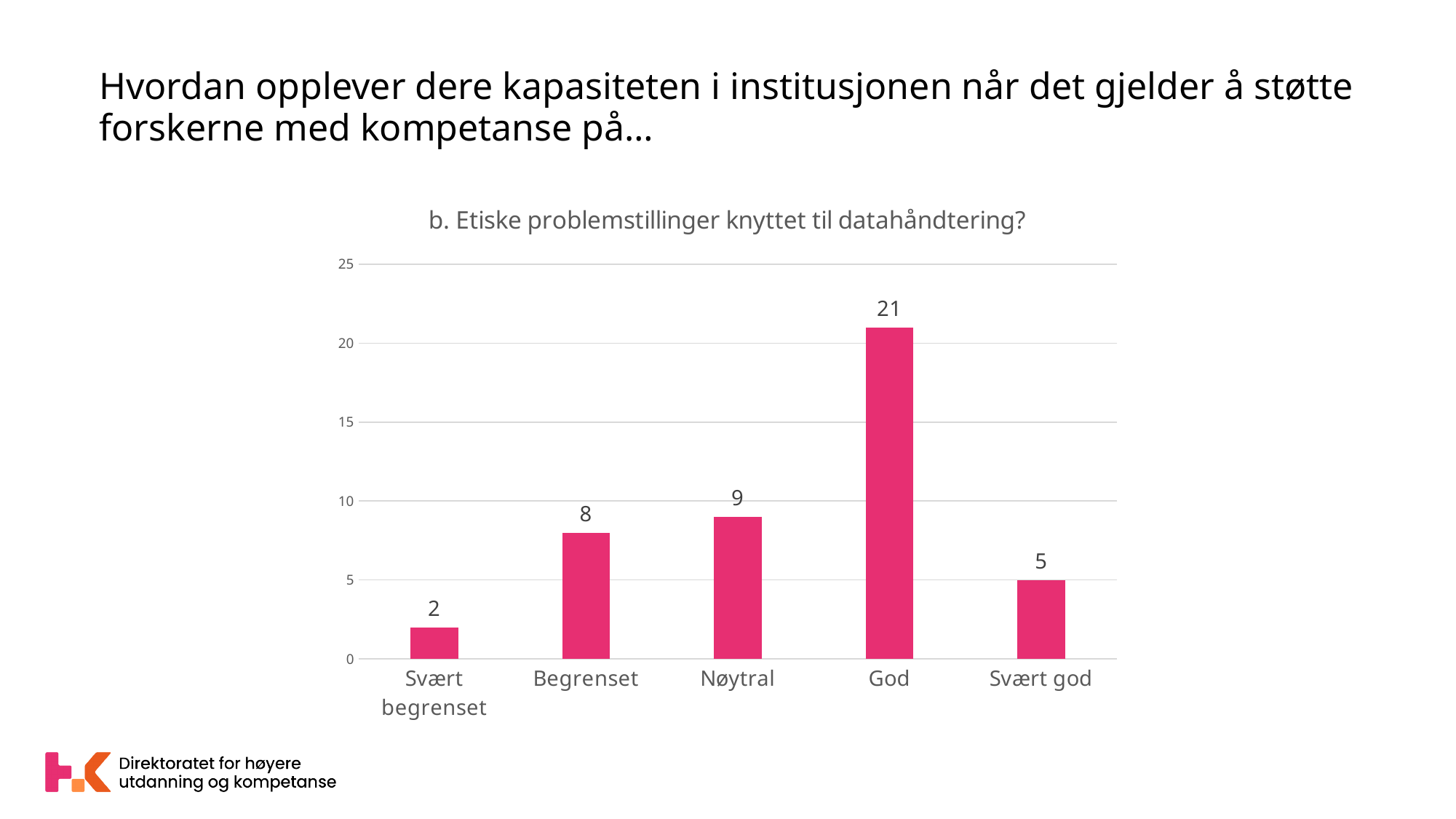
Which category has the highest value? God What is the value for Svært god? 5 What kind of chart is shown on the slide? bar chart What is the value for Svært begrenset? 2 What is the title of the chart? b. Etiske problemstillinger knyttet til datahåndtering? What is the difference between the values for God and Begrenset? 13 Is the value for God greater or less than 20? greater How many categories are shown on the x axis? 5 What is the value for God? 21 What is the value for Nøytral? 9 Which category has the lowest value? Svært begrenset Which is larger, the value for Begrenset or the value for Svært god? Begrenset